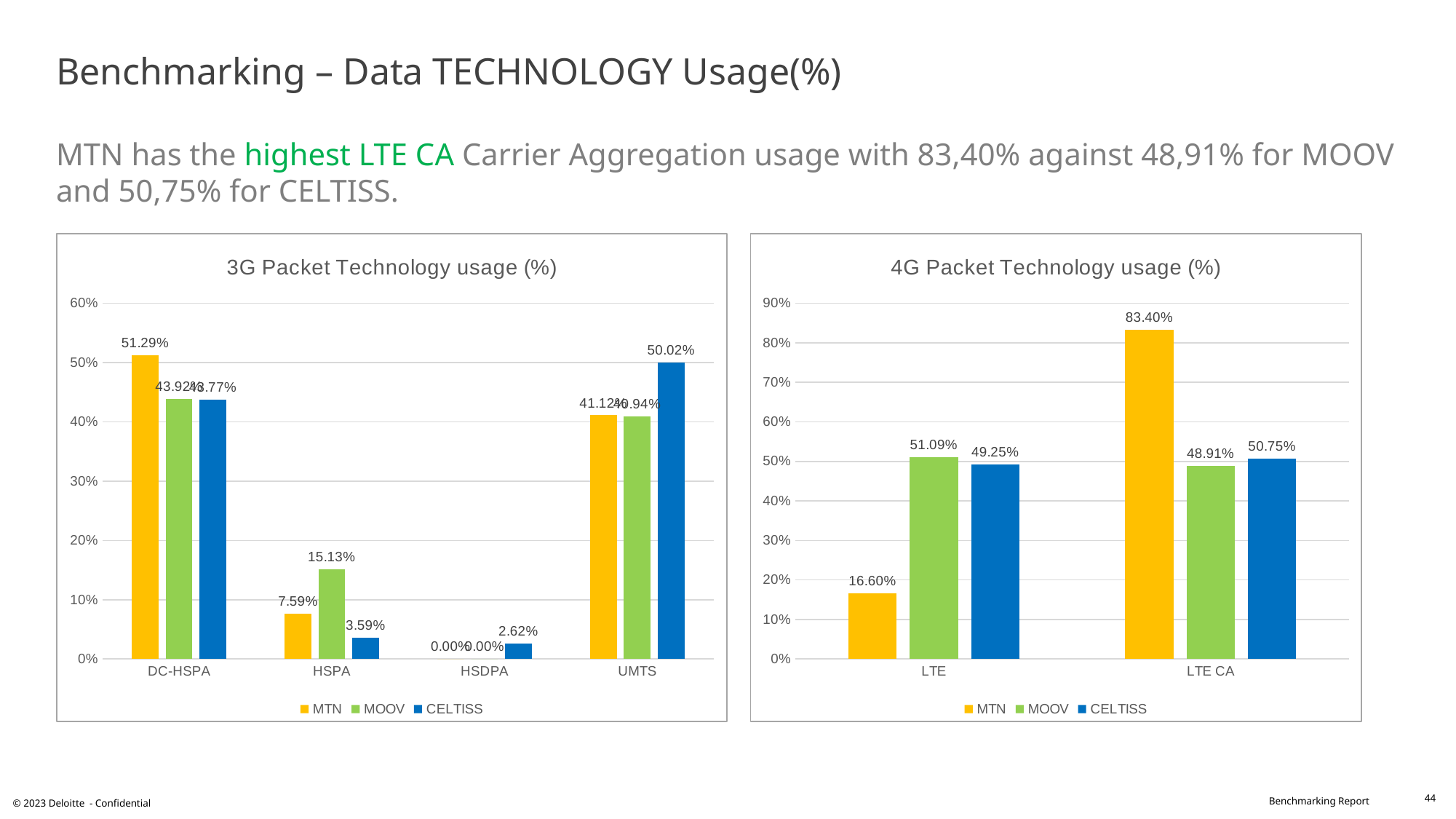
In the 3G Packet Technology usage chart, which is larger at HSPA: MTN or CELTISS? MTN What type of chart is the 4G Packet Technology usage chart? Bar chart In the 3G Packet Technology usage chart, what is the value for CELTISS at UMTS? 50.02% In the 4G Packet Technology usage chart, which operator has the lowest value at LTE? MTN In the 3G Packet Technology usage chart, what is the value for MTN at DC-HSPA? 51.29% How many series does the legend of the 4G Packet Technology usage chart list? 3 In the 3G Packet Technology usage chart, what is the value for MOOV at HSPA? 15.13% In the 4G Packet Technology usage chart, what is the difference between MTN's LTE CA value and MOOV's LTE CA value? 34.49% In the 4G Packet Technology usage chart, what is the value for MTN at LTE CA? 83.40% In the 4G Packet Technology usage chart, what is the value for MOOV at LTE? 51.09% In the 3G Packet Technology usage chart, which operator has the highest value at HSPA? MOOV How many categories are shown on the x axis of the 3G Packet Technology usage chart? 4